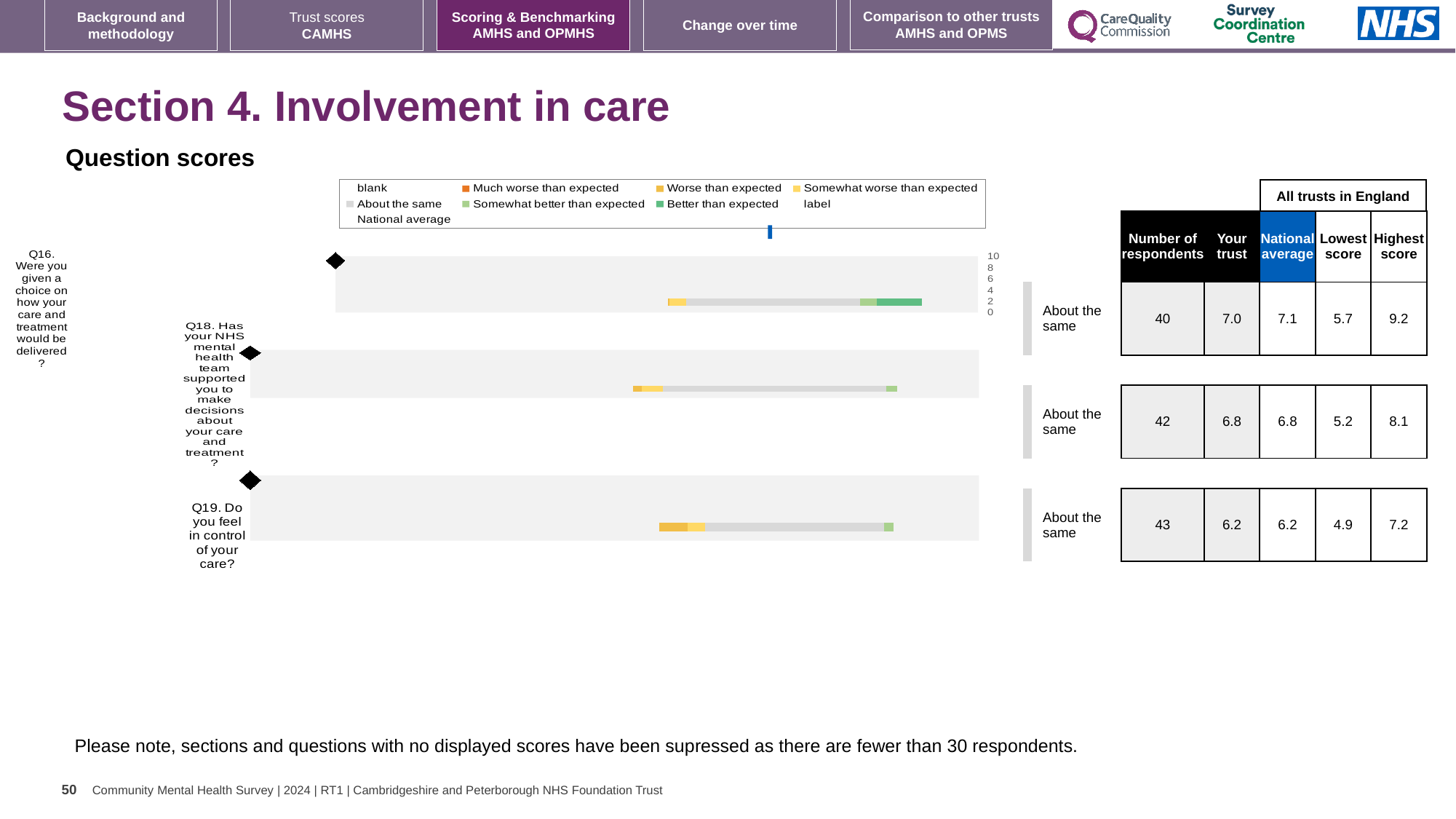
For Q16, which is larger: the 'Your trust' score or the national average? National average What is the 'Your trust' score for Q16 (Were you given a choice on how your care and treatment would be delivered?)? 7.0 What is the highest score across all trusts in England for Q16? 9.2 What kind of chart is used to show the question scores? Bar chart What benchmark category is shown for Q19 (Do you feel in control of your care?)? About the same What is the difference between the highest score (9.2) and the lowest score (5.7) for Q16? 3.5 How many respondents answered Q19 (Do you feel in control of your care?)? 43 What is the national average score for Q18 (Has your NHS mental health team supported you to make decisions about your care and treatment?)? 6.8 How many questions are plotted in the Question scores charts? 3 Which of the three questions has the highest 'Your trust' score? Q16 Which of the three questions has the lowest 'Your trust' score? Q19 What is the total number of respondents across Q16, Q18 and Q19? 125